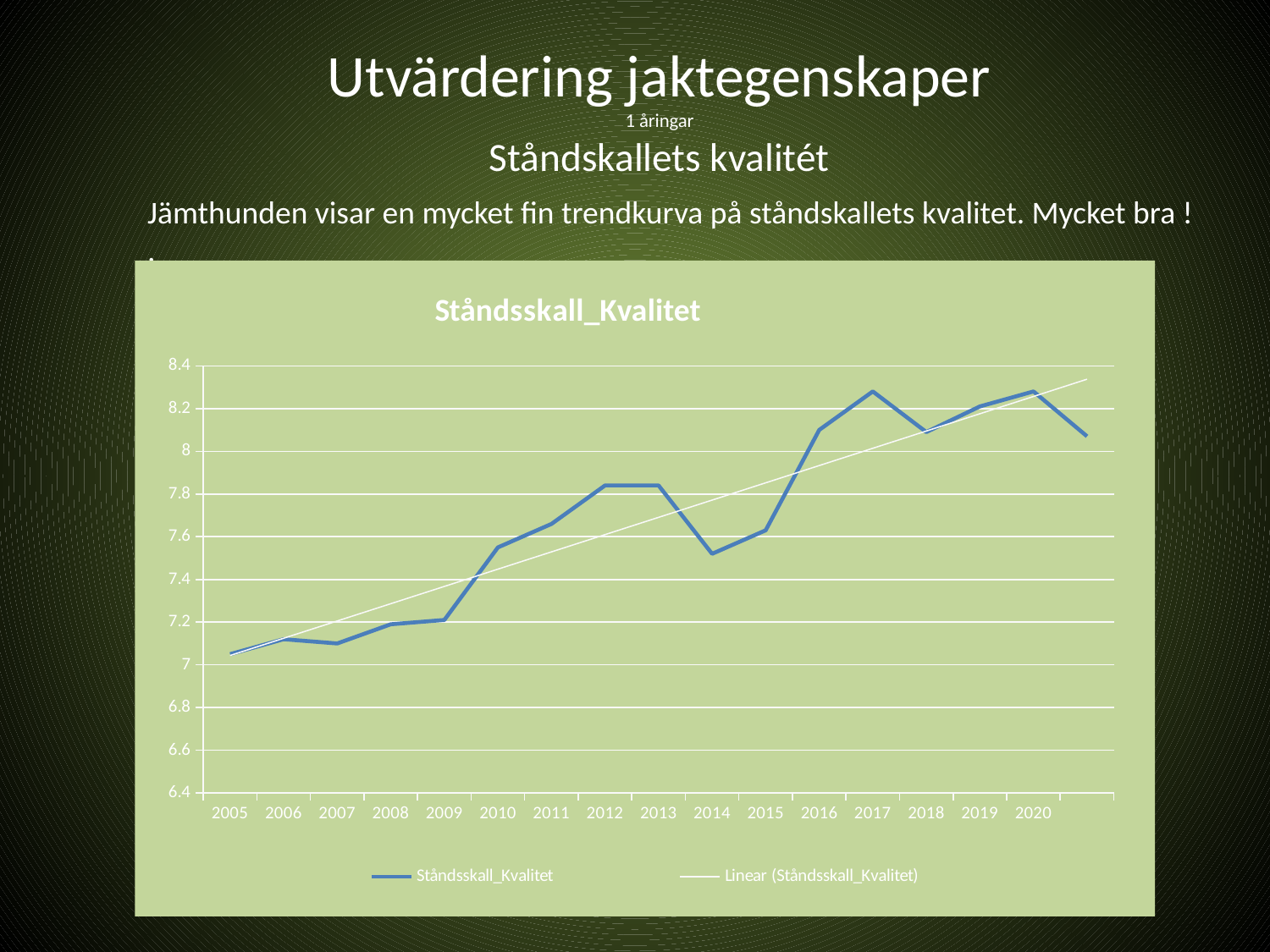
Which year has the higher value, 2014 or 2016? 2016 What is the second entry in the chart legend? Linear (Ståndsskall_Kvalitet) What kind of chart is shown on the slide? line chart How many entries does the chart legend list? 2 Is the value for 2014 greater or less than 7.6? less Is the value for 2005 greater or less than 7.2? less Overall, do the values of Ståndsskall_Kvalitet rise or fall from 2005 to 2020? rise Which year has the higher value, 2007 or 2012? 2012 What is the title of the chart? Ståndsskall_Kvalitet How many years are labelled on the x axis of the chart? 16 Is the value for 2017 greater or less than 8.2? greater